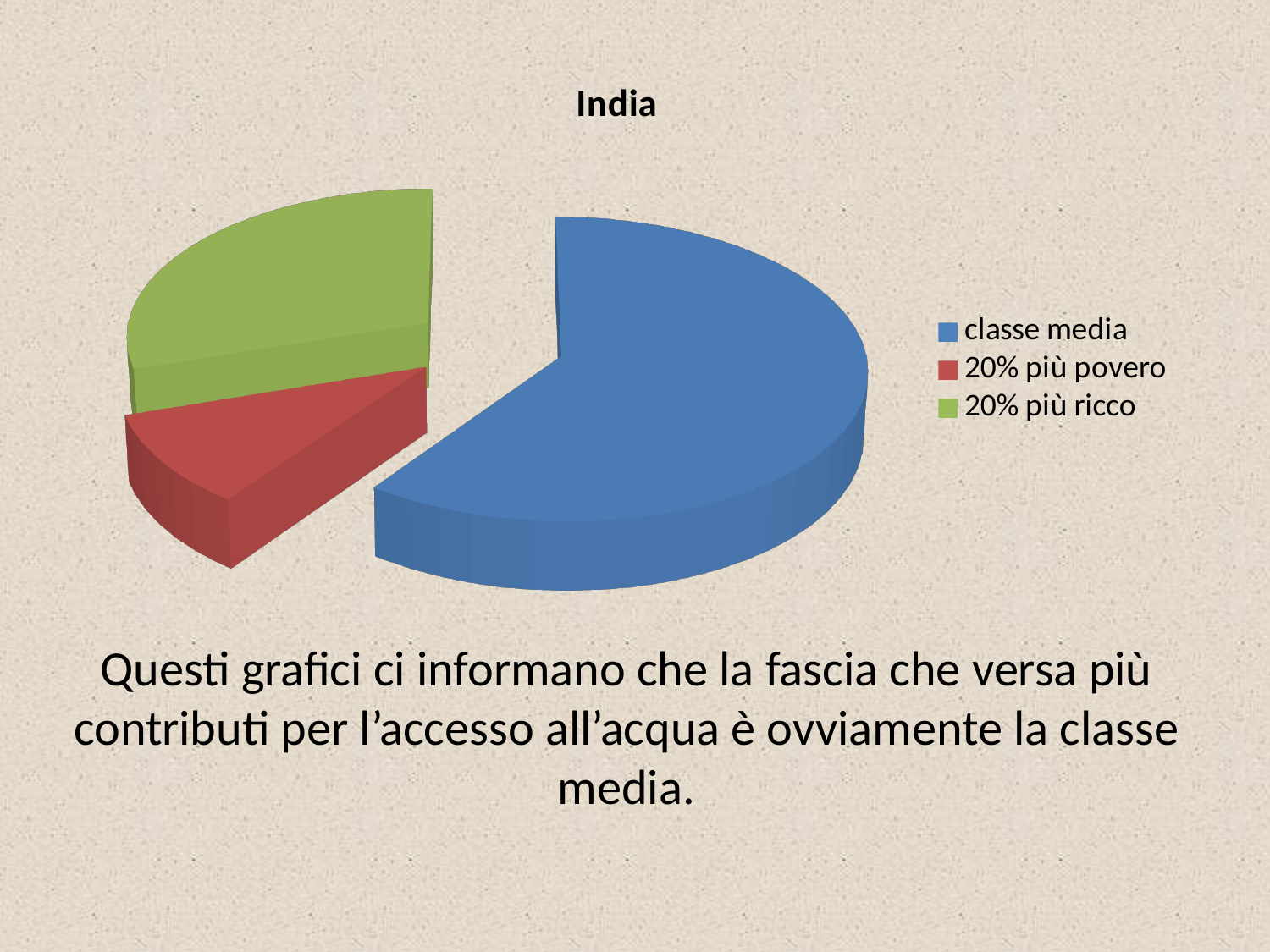
Which slice is larger, classe media or 20% più ricco? classe media Which slice is larger, 20% più ricco or 20% più povero? 20% più ricco What kind of chart is shown on the slide? pie chart How many slices does the pie chart have? 3 What colour is the slice for classe media? blue Which category has the largest slice of the pie? classe media What is the title of the chart? India Which slice is larger, 20% più povero or classe media? classe media How many entries does the legend list? 3 Which category has the smallest slice of the pie? 20% più povero